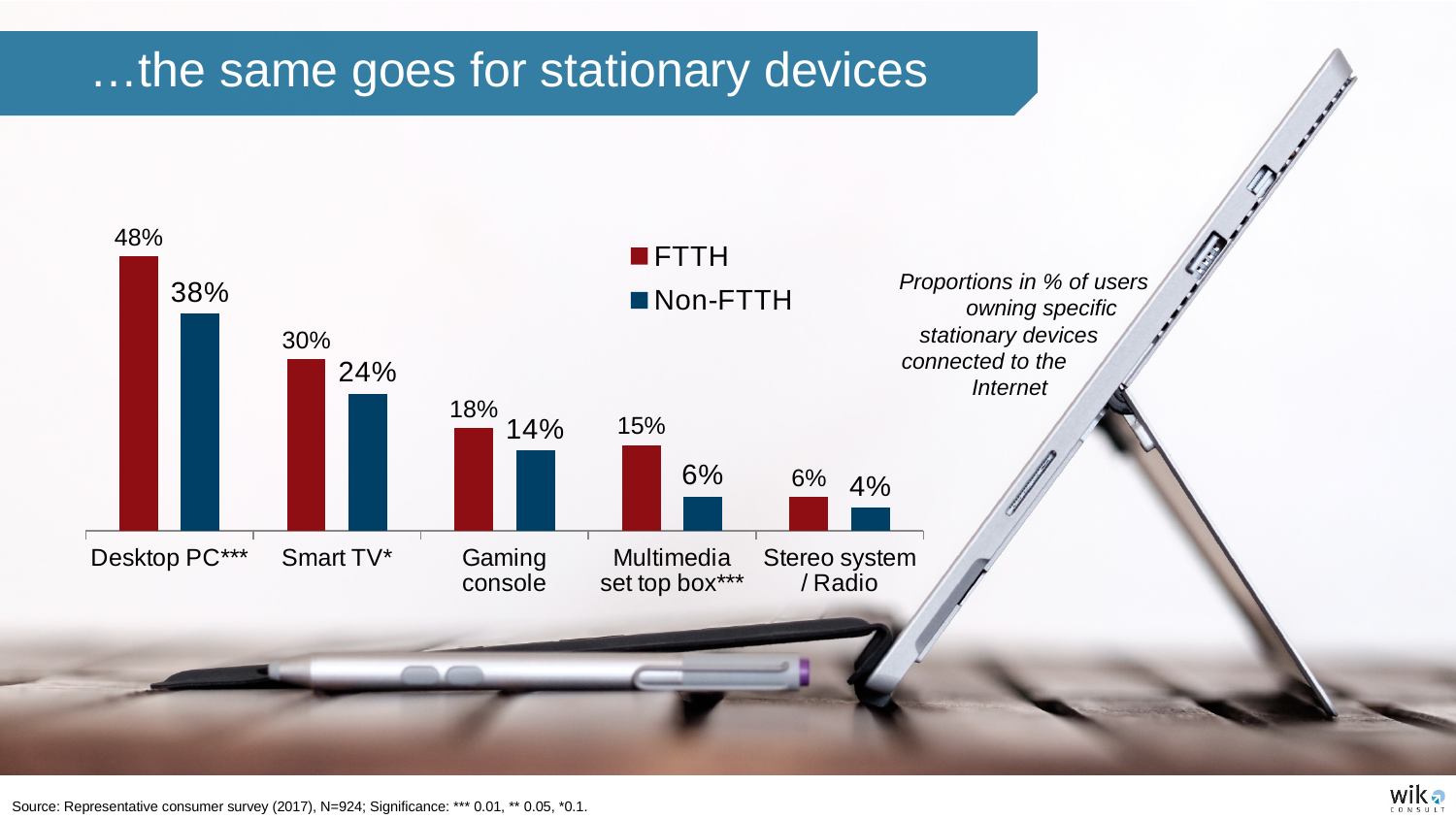
What is the difference between the FTTH and Non-FTTH values for Multimedia set top box***? 9% Do the FTTH values rise or fall from left to right along the x axis? Fall How many device categories are shown on the x axis? 5 What kind of chart is shown on the slide? Bar chart Which category has the highest FTTH value? Desktop PC*** What is the Non-FTTH value for Smart TV*? 24% How many series does the legend list? 2 Which category has the lowest Non-FTTH value? Stereo system / Radio What is the difference between the FTTH and Non-FTTH values for Desktop PC***? 10% Which is larger: the FTTH value for Gaming console or the Non-FTTH value for Smart TV*? Non-FTTH value for Smart TV* What is the Non-FTTH value for Multimedia set top box***? 6% What is the FTTH value for Desktop PC***? 48%